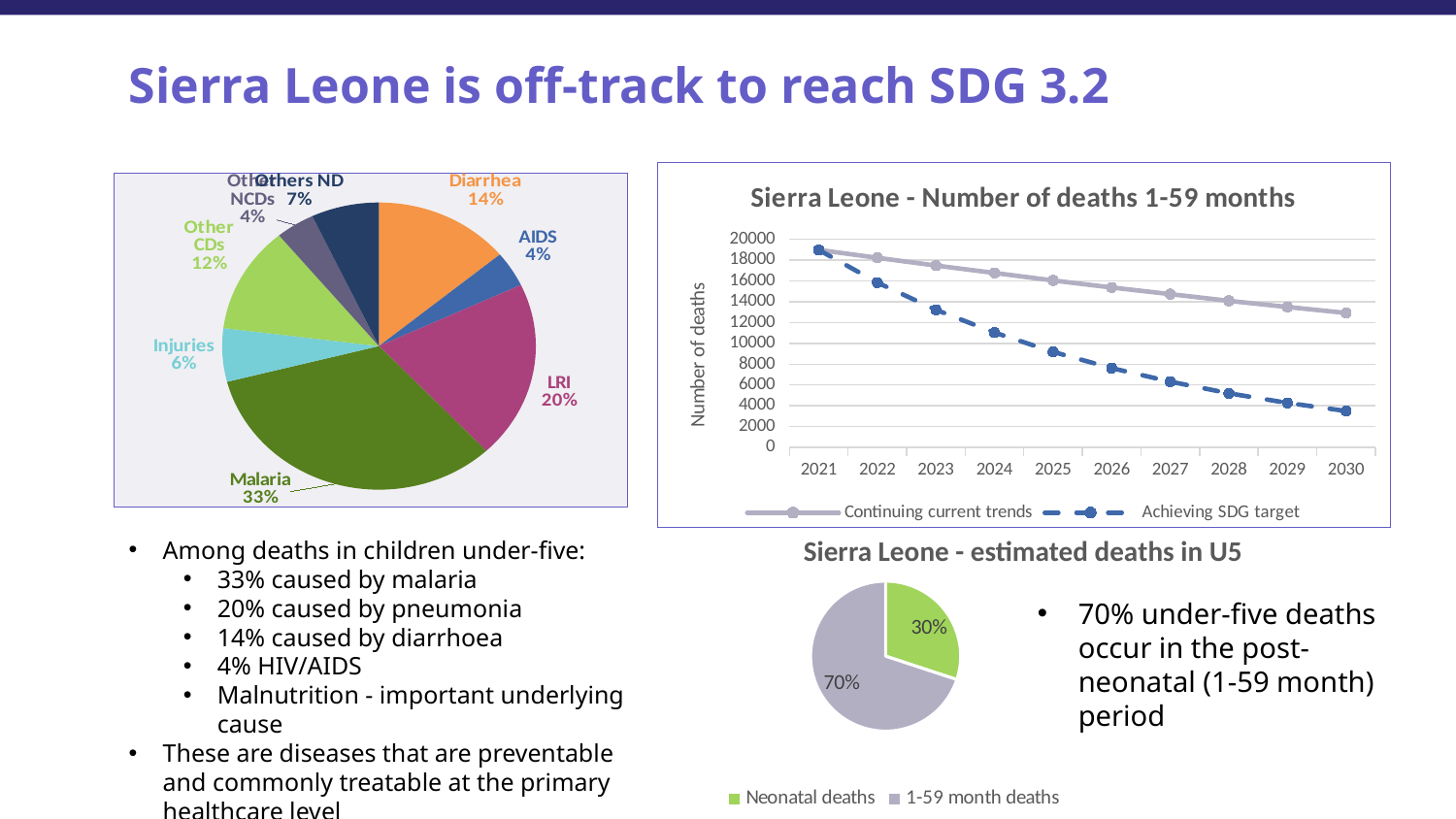
In the chart 'Sierra Leone - Number of deaths 1-59 months', how many series does the legend list? 2 In the pie chart on the left of the slide, which cause has the largest share? Malaria In the chart 'Sierra Leone - Number of deaths 1-59 months', do the values for 'Achieving SDG target' rise or fall from 2021 to 2030? Fall In the pie chart on the left of the slide, what is the difference in percentage points between the Diarrhea share and the AIDS share? 10 In the pie chart on the left of the slide, what share is attributed to LRI? 20% In the pie chart on the left of the slide, what share of under-five deaths is attributed to Malaria? 33% In the chart 'Sierra Leone - Number of deaths 1-59 months', how many years are shown on the x axis? 10 In the chart 'Sierra Leone - Number of deaths 1-59 months', is the value for 'Continuing current trends' in 2030 greater or less than 14000? less In the chart 'Sierra Leone - estimated deaths in U5', what share is Neonatal deaths? 30% What kind of chart is 'Sierra Leone - Number of deaths 1-59 months'? Line chart In the pie chart on the left of the slide, which is larger, the share for Other CDs or the share for Injuries? Other CDs In the chart 'Sierra Leone - Number of deaths 1-59 months', is the value for 'Achieving SDG target' in 2030 greater or less than 4000? less